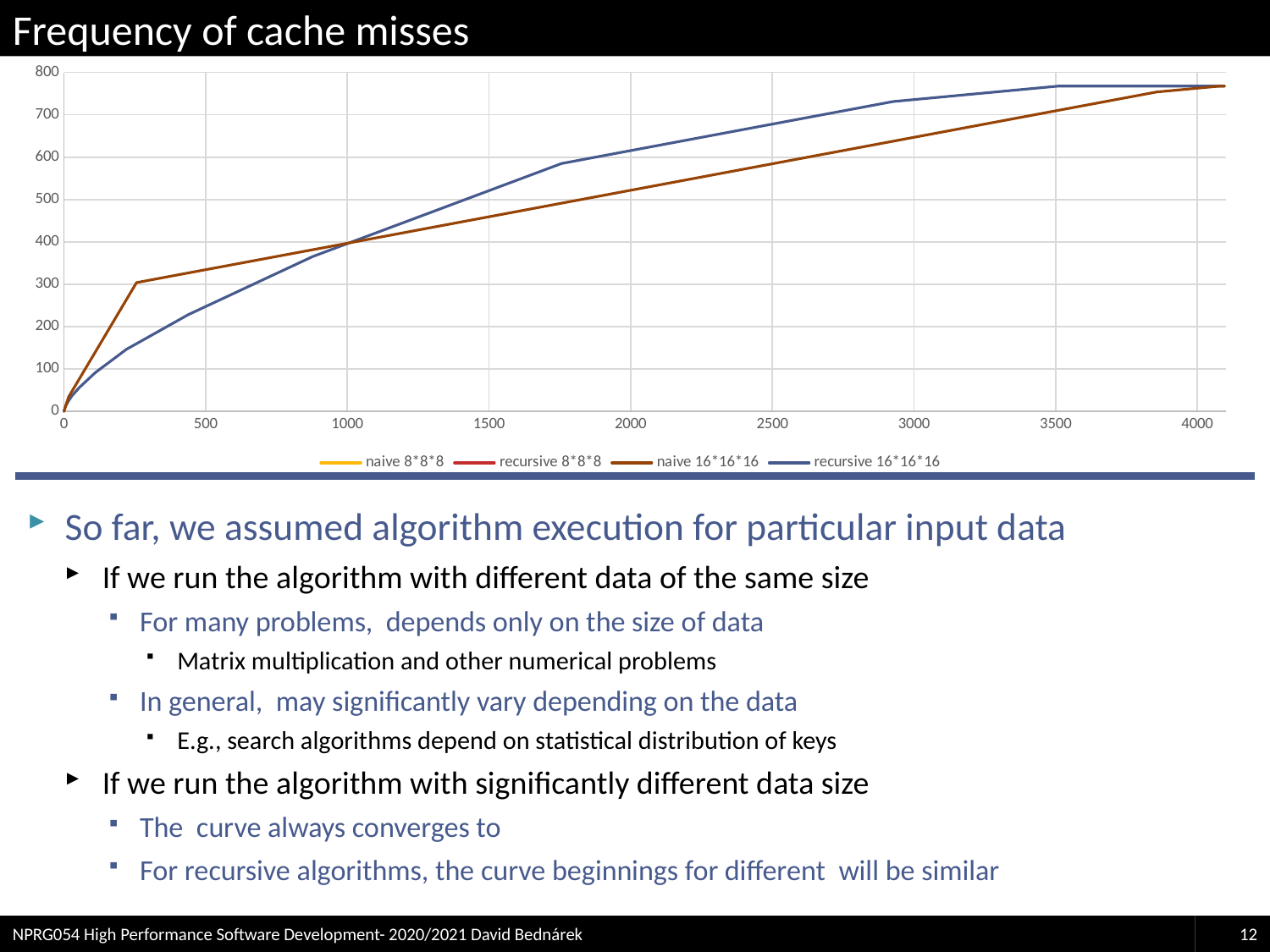
At x = 3000, which series has the higher value, naive 16*16*16 or recursive 16*16*16? recursive 16*16*16 At x = 2000, is the value of the recursive 16*16*16 series greater or less than 500? greater What kind of chart is shown on the slide? line chart Do the values of the recursive 16*16*16 series rise or fall as the x axis increases? rise At x = 1500, is the value of the naive 16*16*16 series greater or less than 500? less What is the title of the chart? Frequency of cache misses At x = 500, which series has the higher value, naive 16*16*16 or recursive 16*16*16? naive 16*16*16 How many series does the chart legend list? 4 At x = 3000, is the value of the recursive 16*16*16 series greater or less than 700? greater Which series is drawn in blue? recursive 16*16*16 Do the values of the naive 16*16*16 series rise or fall as the x axis increases? rise